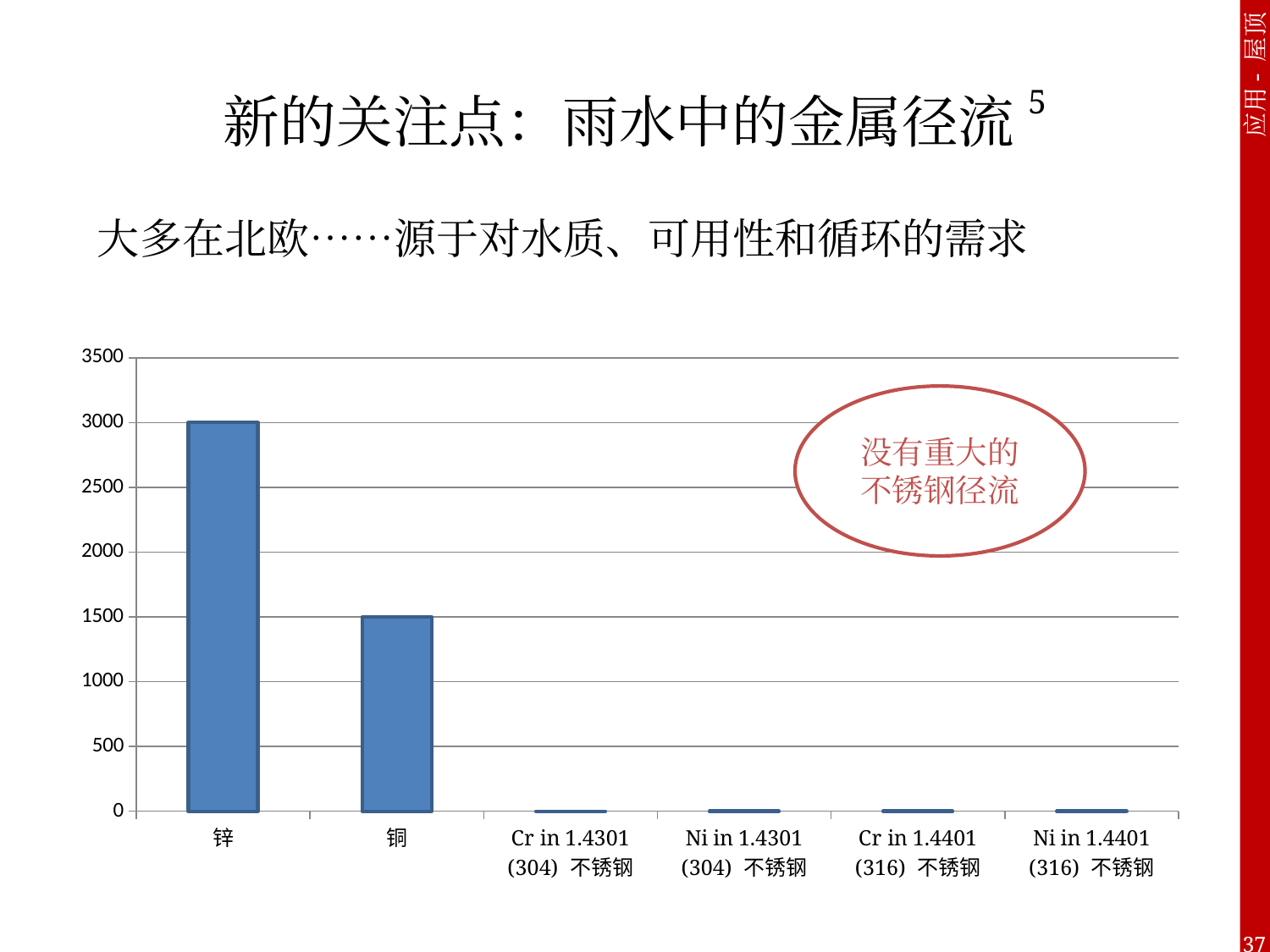
Which category has the highest bar in the chart? 锌 Which is larger, the value for 铜 or the value for Ni in 1.4401 (316) 不锈钢? 铜 What is the difference between the values for 锌 and 铜? 1500 Which is larger, the value for 锌 or the value for 铜? 锌 Is the value for Cr in 1.4301 (304) 不锈钢 greater or less than 500? less What kind of chart is shown on the slide? bar chart What does the red circled annotation on the chart say? 没有重大的不锈钢径流 How many categories are shown on the x axis of the chart? 6 What is the value for 铜 in the chart? 1500 What is the value for 锌 in the chart? 3000 Is the value for 锌 greater or less than 2500? greater Is the value for 铜 greater or less than 2000? less